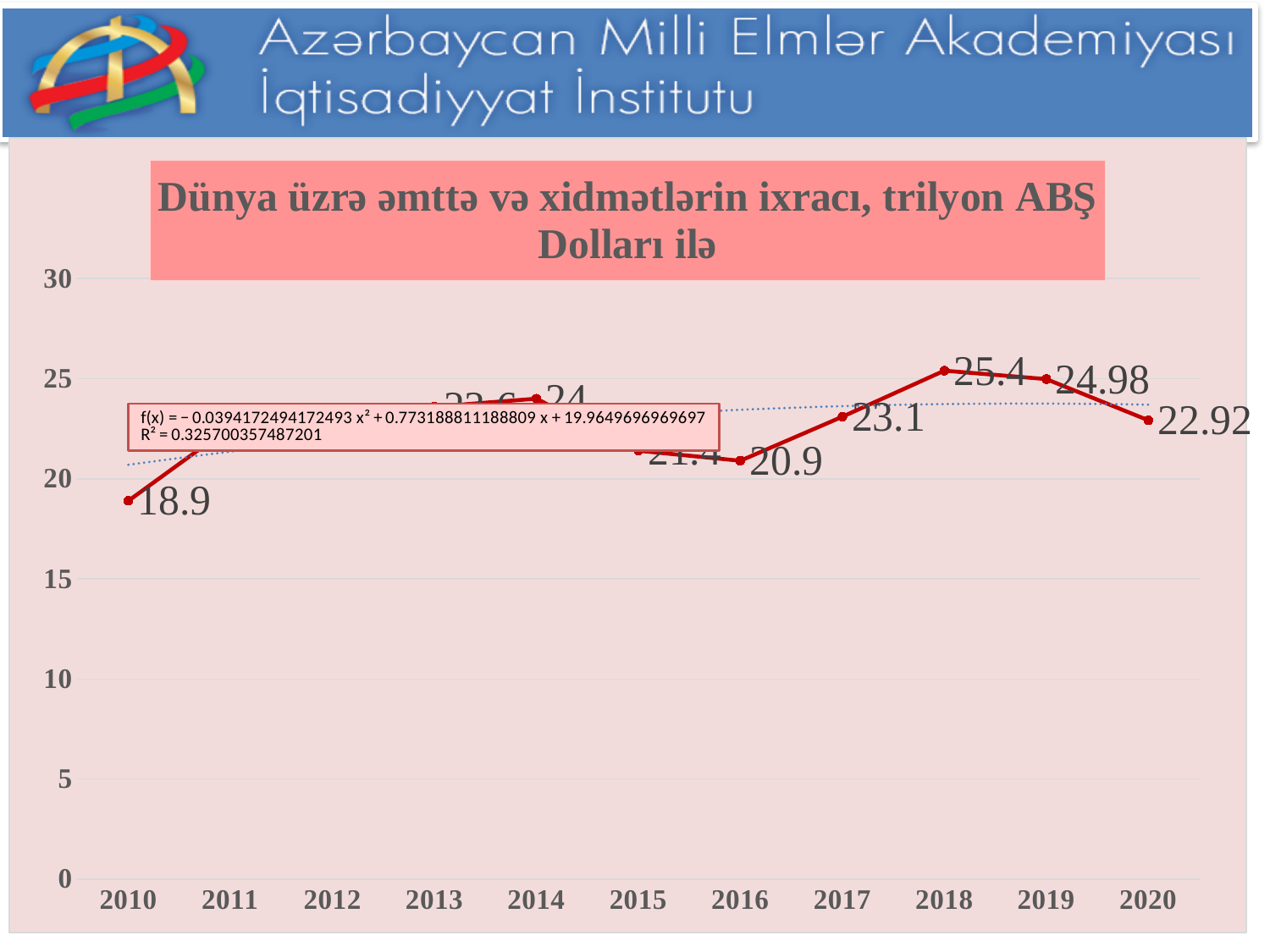
Do the values rise or fall from 2018 to 2020? fall What is the value for 2016? 20.9 Which is larger, the value for 2014 or the value for 2016? 2014 Which year has the lowest value? 2010 What is the title of the chart? Dünya üzrə əmttə və xidmətlərin ixracı, trilyon ABŞ Dolları ilə What is the value for 2020? 22.92 What is the value for 2018? 25.4 How many years are shown on the x axis? 11 Which year has the highest value? 2018 What type of chart is shown on the slide? line chart What is the value for 2010? 18.9 What is the difference between the values for 2018 and 2017? 2.3